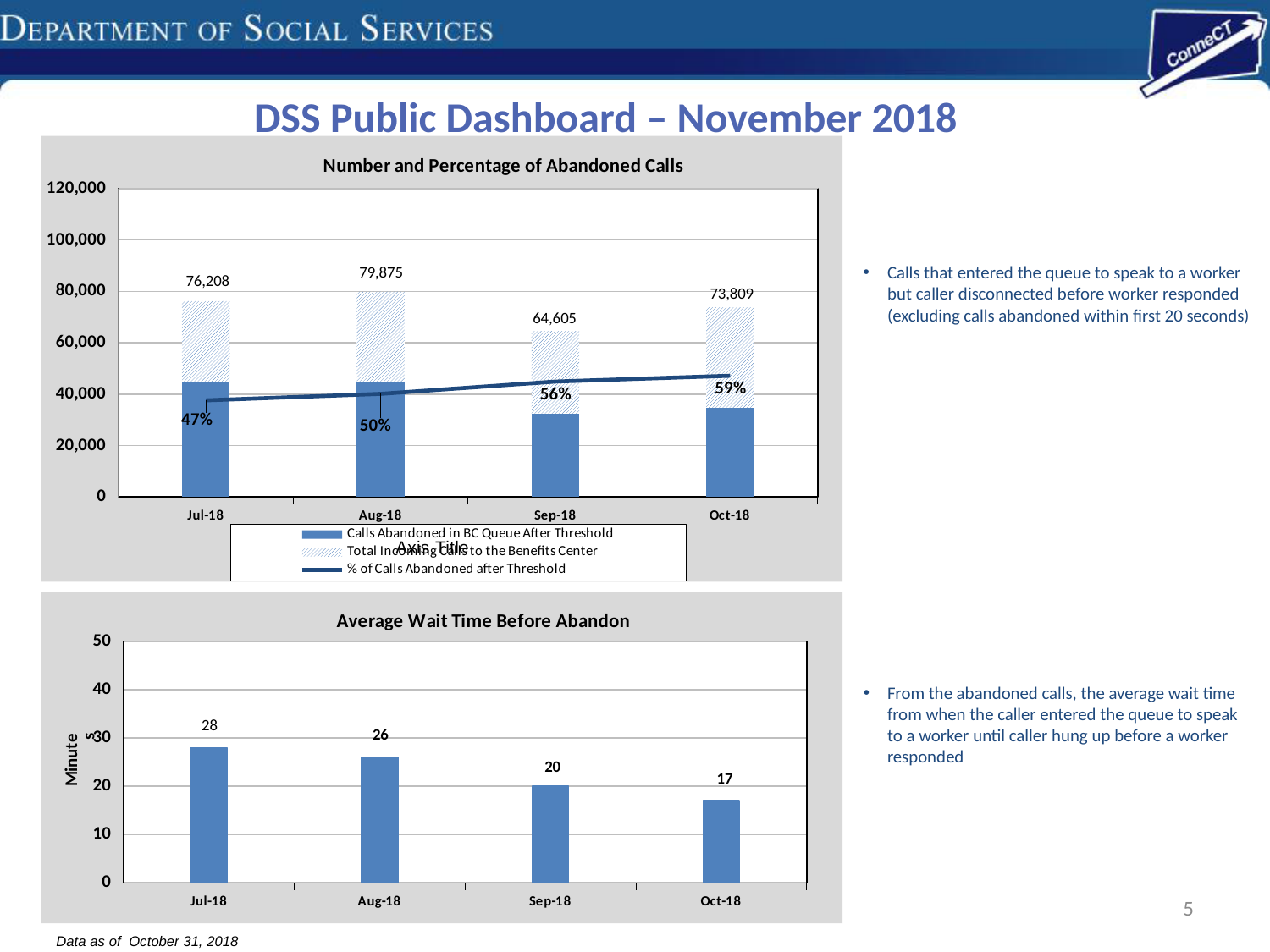
In the 'Number and Percentage of Abandoned Calls' chart, which month has the highest total incoming calls to the Benefits Center? Aug-18 How many series does the legend of the 'Number and Percentage of Abandoned Calls' chart list? 3 In the 'Average Wait Time Before Abandon' chart, what is the value for Jul-18? 28 In the 'Average Wait Time Before Abandon' chart, which month has the lowest average wait time? Oct-18 In the 'Number and Percentage of Abandoned Calls' chart, which month has the lowest total incoming calls to the Benefits Center? Sep-18 In the 'Number and Percentage of Abandoned Calls' chart, what is the total incoming calls value for Aug-18? 79,875 In the 'Number and Percentage of Abandoned Calls' chart, what is the difference between total incoming calls in Aug-18 and Sep-18? 15,270 In the 'Number and Percentage of Abandoned Calls' chart, what is the % of calls abandoned after threshold for Oct-18? 59% In the 'Average Wait Time Before Abandon' chart, what is the difference between the Jul-18 and Oct-18 values? 11 In the 'Number and Percentage of Abandoned Calls' chart, is the value for calls abandoned in BC queue after threshold in Sep-18 greater or less than 40,000? less In the 'Number and Percentage of Abandoned Calls' chart, does the % of calls abandoned after threshold rise or fall from Jul-18 to Oct-18? rise What kind of chart is the 'Average Wait Time Before Abandon' chart? bar chart